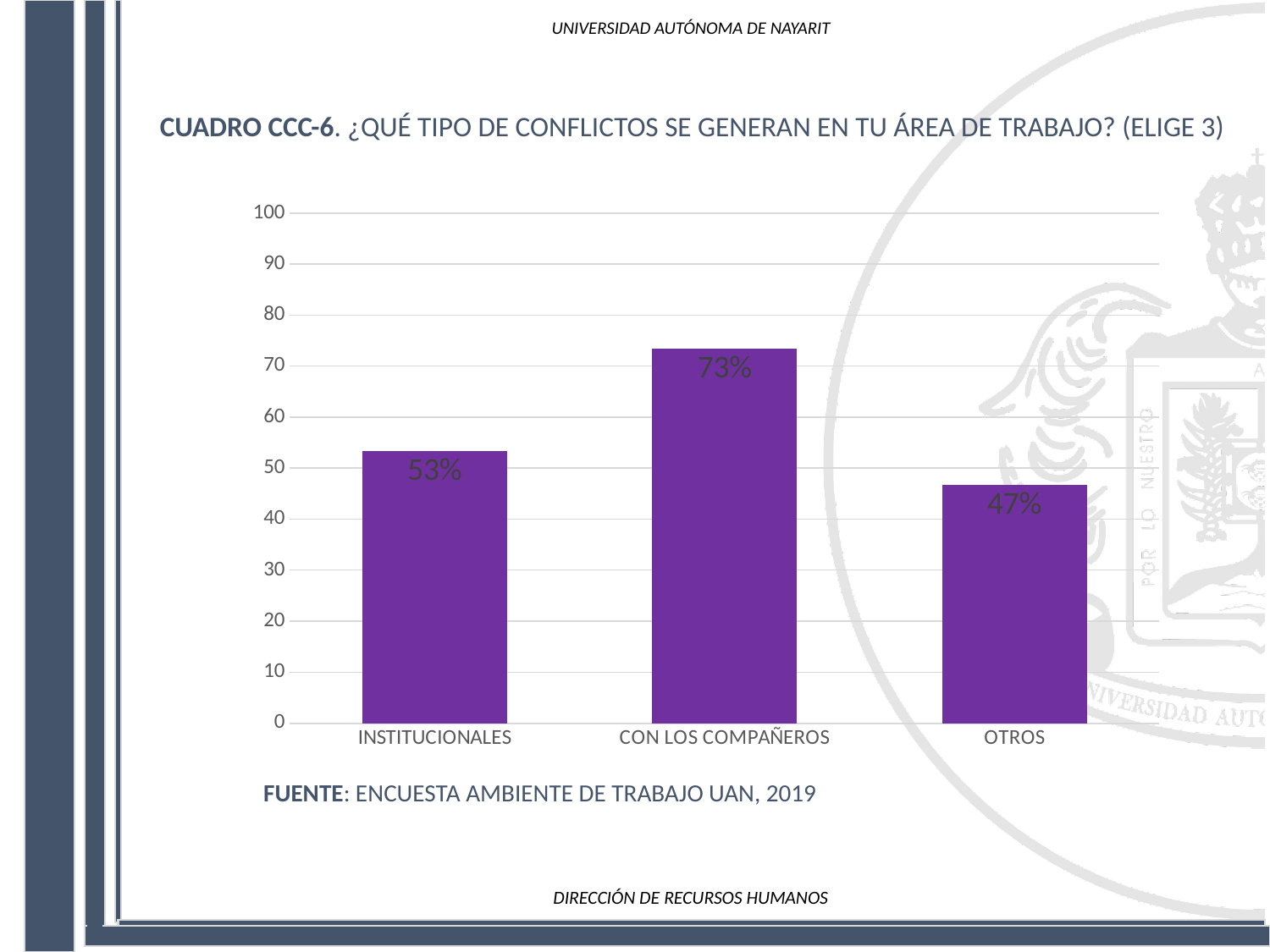
Which category has the highest value? CON LOS COMPAÑEROS What is the value for CON LOS COMPAÑEROS? 73% What kind of chart is shown on the slide? bar chart How many categories are shown on the x axis? 3 What is the value for INSTITUCIONALES? 53% What is the difference between the values for INSTITUCIONALES and OTROS? 6% What source is cited below the chart? ENCUESTA AMBIENTE DE TRABAJO UAN, 2019 What is the value for OTROS? 47% Which category has the lowest value? OTROS What is the difference between the values for CON LOS COMPAÑEROS and INSTITUCIONALES? 20% Which is larger, the value for INSTITUCIONALES or the value for OTROS? INSTITUCIONALES Is the value for CON LOS COMPAÑEROS greater or less than 70? greater